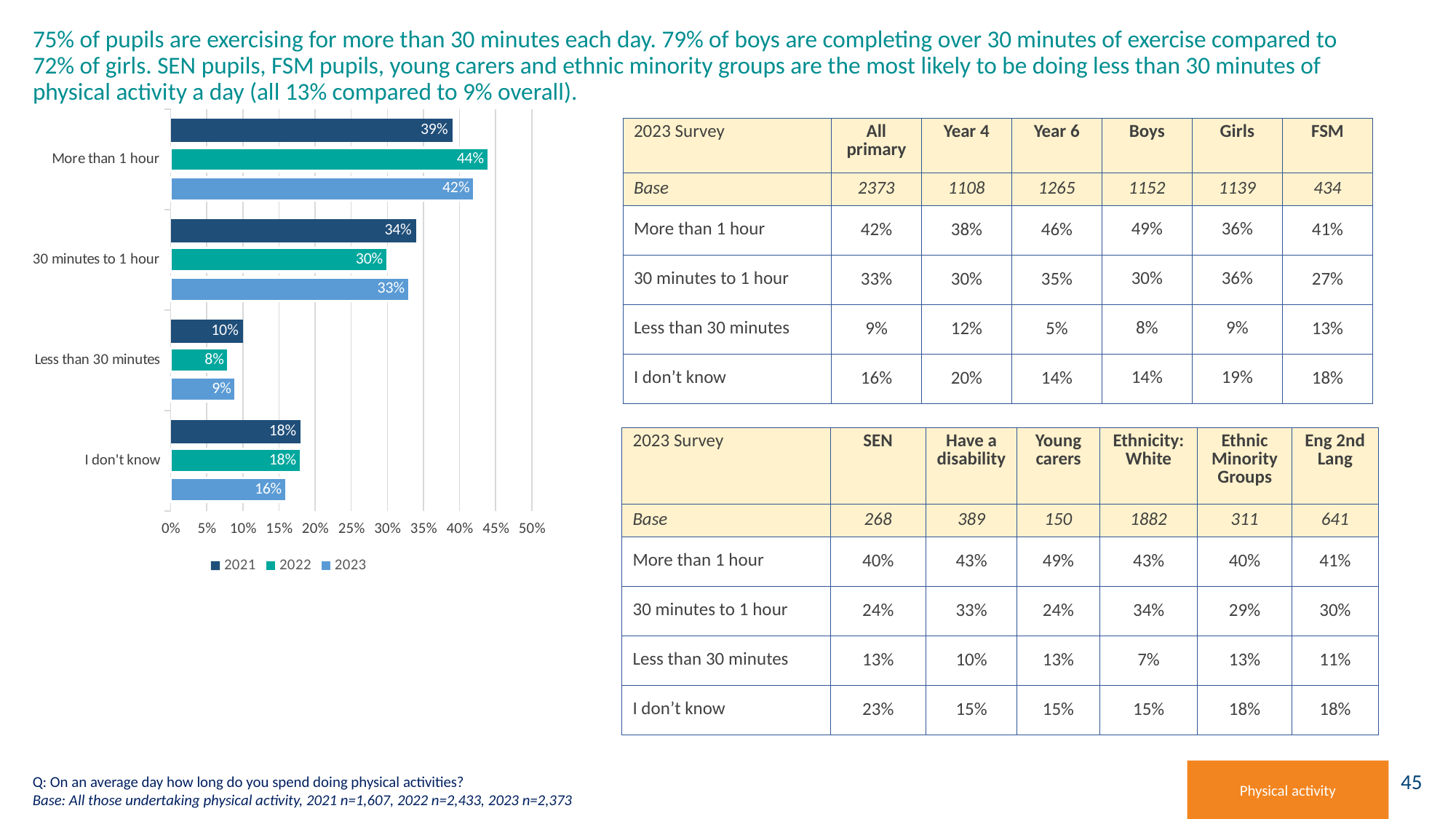
Which years are listed in the bar chart legend? 2021, 2022, 2023 What is the difference between the 2022 and 2021 values for 'More than 1 hour' in the bar chart? 5% How many categories are shown on the bar chart? 4 What is the 2022 value for 'More than 1 hour' in the bar chart? 44% Which category has the lowest 2022 value in the bar chart? Less than 30 minutes What is the 2023 value for '30 minutes to 1 hour' in the bar chart? 33% What type of chart is shown on the slide? bar chart Is the 2023 value for 'I don't know' in the bar chart greater or less than 20%? less In the bar chart, is the 2021 value for '30 minutes to 1 hour' larger or smaller than the 2022 value? larger How many series does the bar chart legend list? 3 Which category has the highest 2023 value in the bar chart? More than 1 hour What is the 2021 value for 'Less than 30 minutes' in the bar chart? 10%